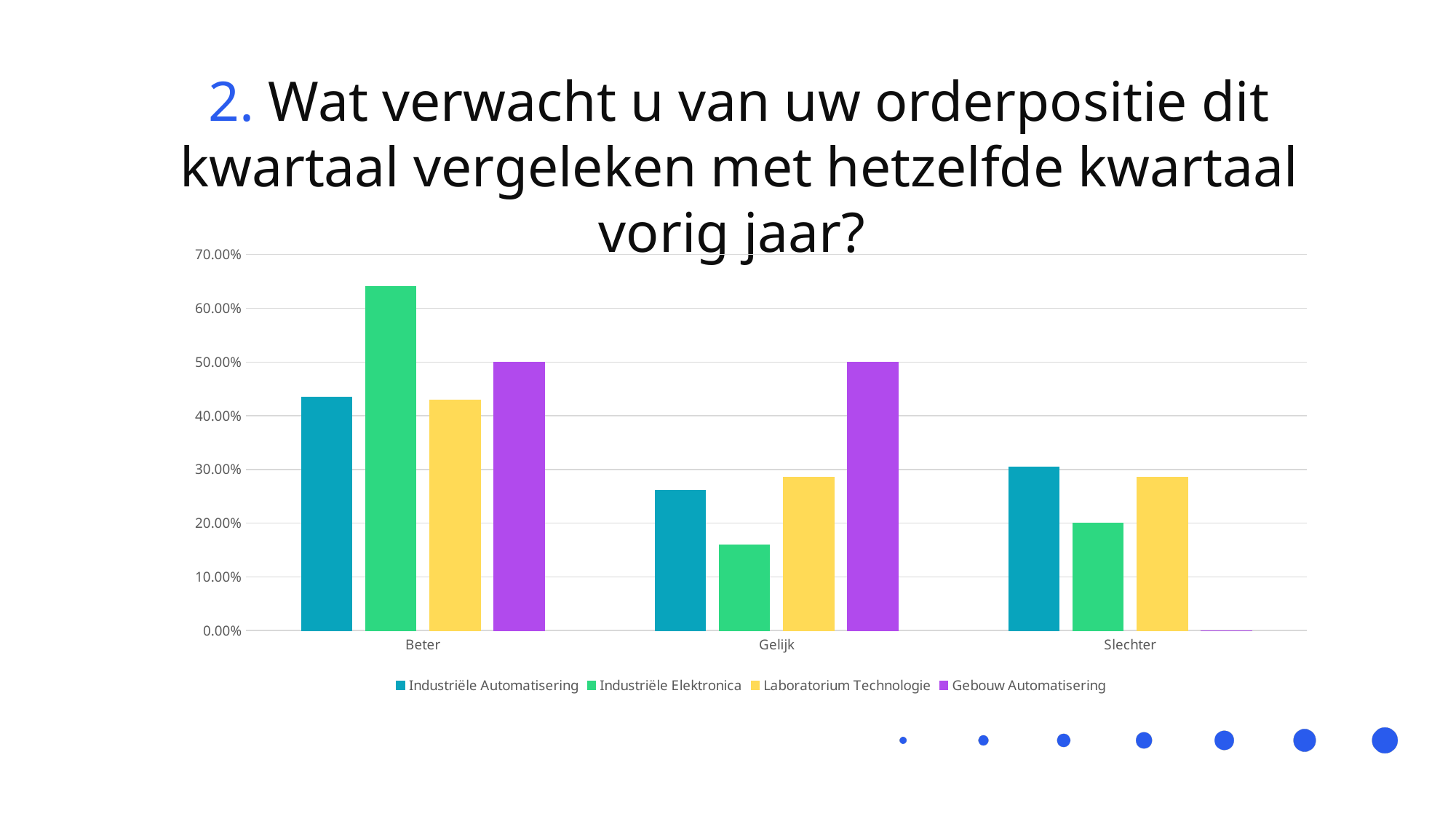
Which series has the highest value in the Gelijk category? Gebouw Automatisering Which is larger in the Gelijk category: Industriële Automatisering or Industriële Elektronica? Industriële Automatisering What is the value for Gebouw Automatisering in the Slechter category? 0.00% Is the value for Industriële Elektronica in the Gelijk category greater or less than 20.00%? less What kind of chart is shown on the slide? bar chart How many categories are shown on the x axis? 3 What is the value for Gebouw Automatisering in the Gelijk category? 50.00% Which series has the highest value in the Beter category? Industriële Elektronica Is the value for Industriële Elektronica in the Beter category greater or less than 60.00%? greater Which series has the lowest value in the Slechter category? Gebouw Automatisering What is the value for Gebouw Automatisering in the Beter category? 50.00% How many series does the legend list? 4